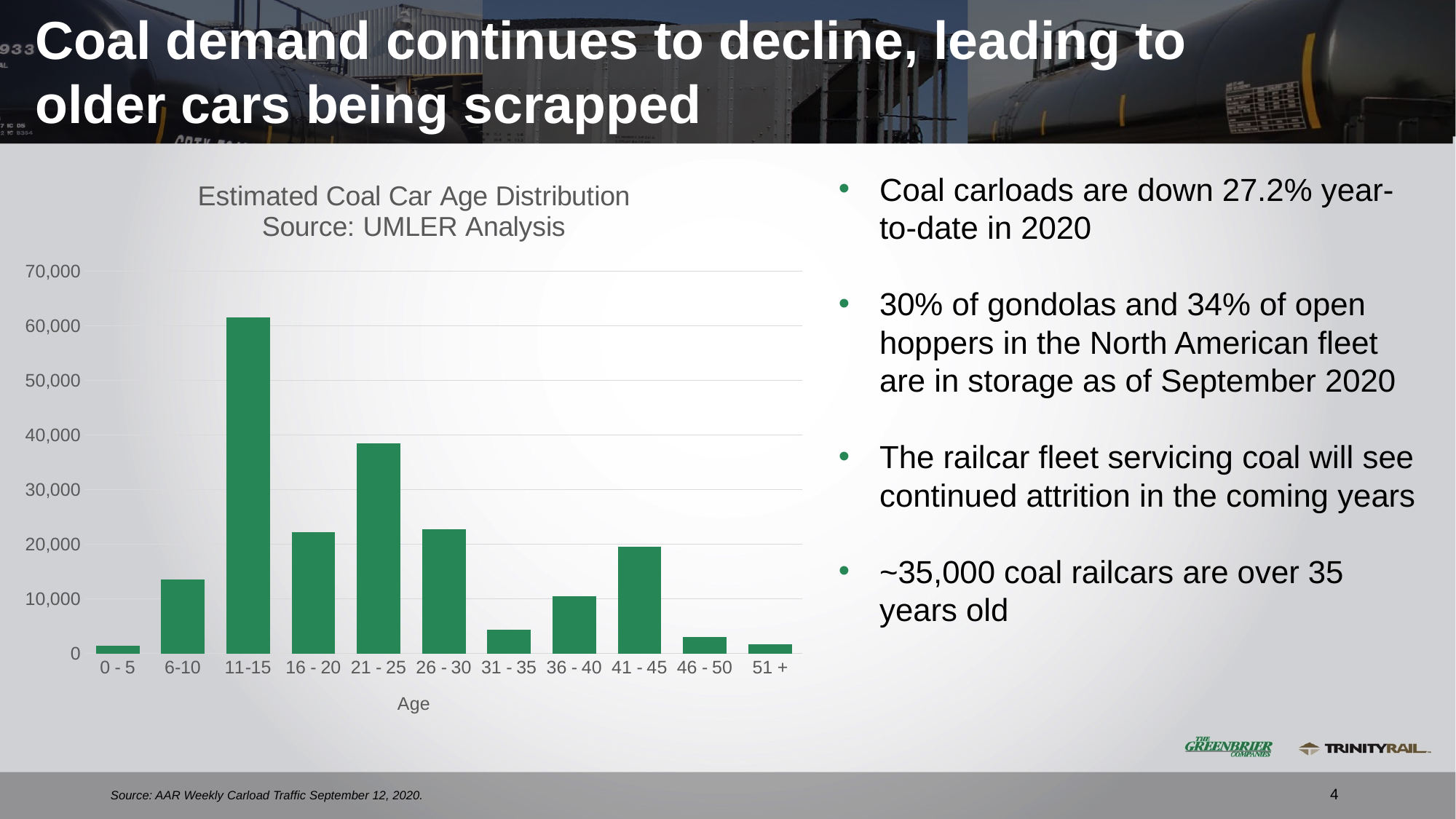
How many age categories are shown on the x axis of the chart? 11 Which has a larger value, the 41 - 45 age category or the 36 - 40 age category? 41 - 45 What is the label on the x axis of the chart? Age Which has a larger value, the 21 - 25 age category or the 16 - 20 age category? 21 - 25 Is the value for the 11-15 age category greater or less than 50,000? greater Is the value for the 6-10 age category greater or less than 10,000? greater Which age category has the highest estimated number of coal cars? 11-15 What is the title of the chart? Estimated Coal Car Age Distribution Source: UMLER Analysis Is the value for the 46 - 50 age category greater or less than 10,000? less What kind of chart is shown on the slide? Bar chart